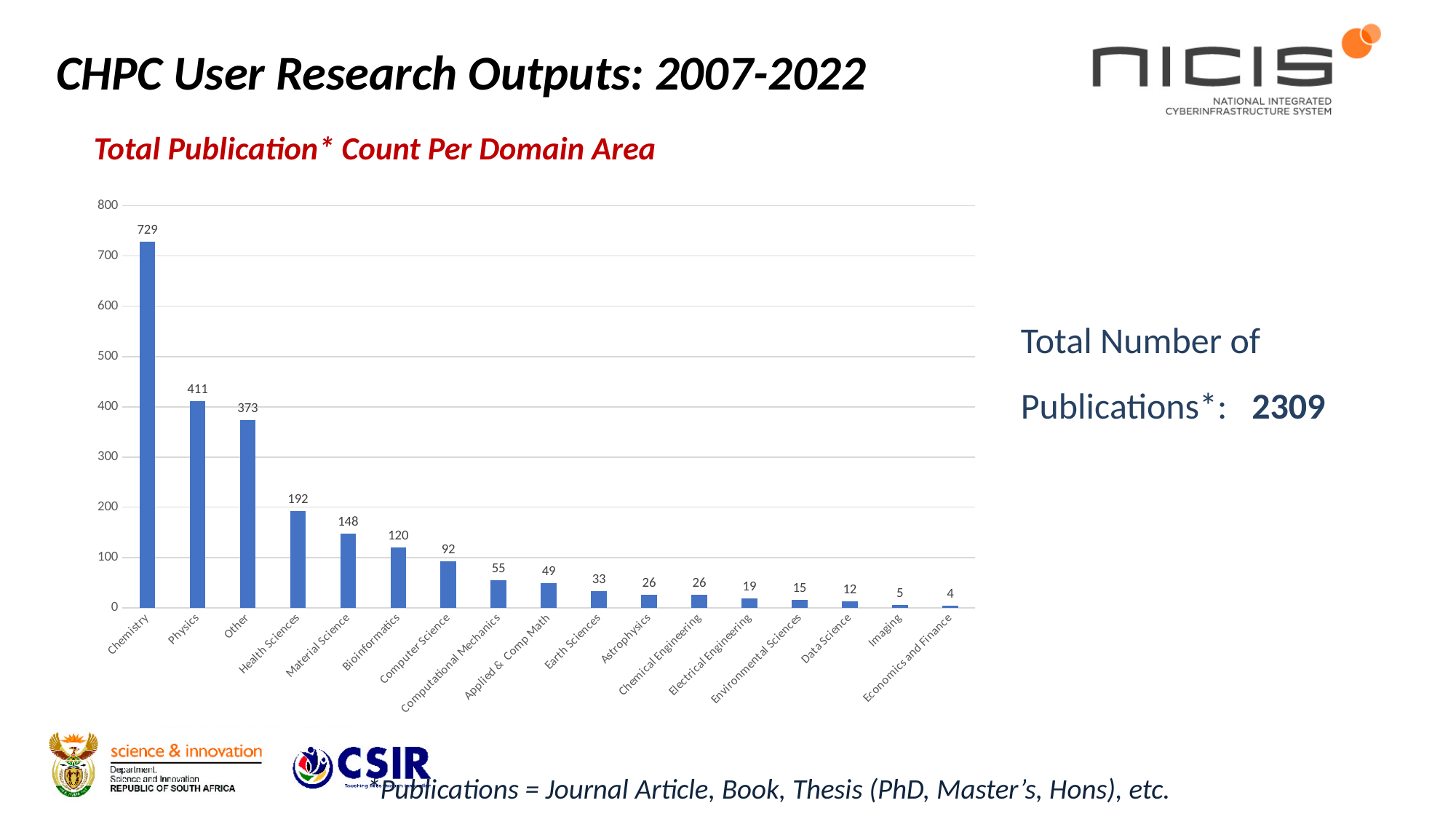
What kind of chart is shown on the slide? Bar chart Which has more publications, Bioinformatics or Computer Science? Bioinformatics What is the title of the chart? Total Publication* Count Per Domain Area Which domain area has the highest publication count? Chemistry How many domain areas are shown on the chart? 17 Which domain area has the lowest publication count? Economics and Finance What is the publication count for Computational Mechanics? 55 What is the publication count for Health Sciences? 192 What is the difference between the publication counts for Material Science and Bioinformatics? 28 What is the difference between the publication counts for Physics and Other? 38 What is the publication count for Chemistry? 729 Do the values rise or fall from left to right along the x axis? Fall